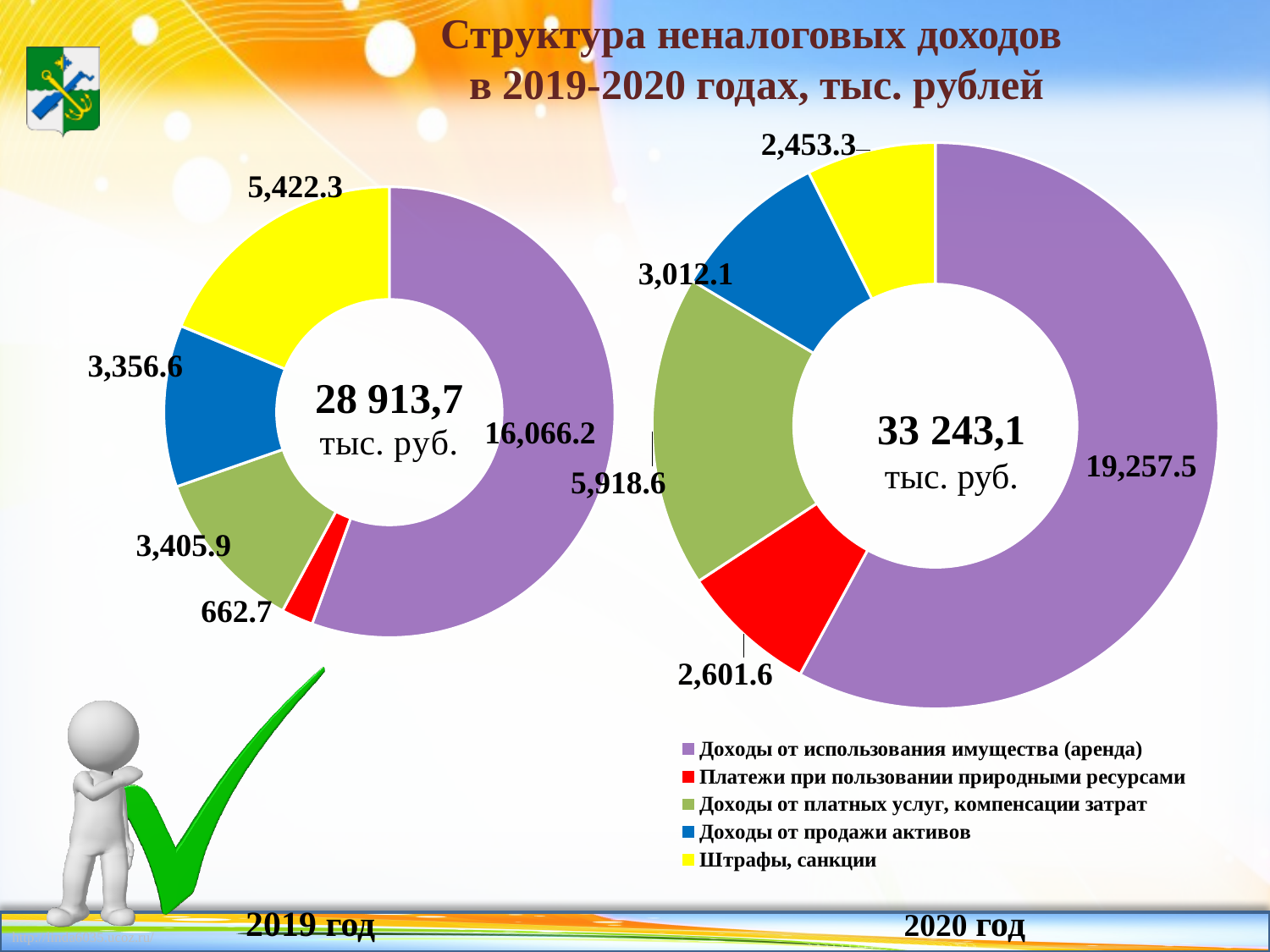
By how much did Доходы от использования имущества (аренда) increase from the 2019 chart to the 2020 chart? 3,191.3 In the 2019 chart, what is the difference between Штрафы, санкции and Доходы от продажи активов? 2,065.7 In the 2019 chart, which category has the smallest value? Платежи при пользовании природными ресурсами In the 2019 chart, what is the value for Доходы от использования имущества (аренда)? 16,066.2 In the 2019 chart, what is the value for Штрафы, санкции? 5,422.3 What kind of chart is used for the 2019 and 2020 data? doughnut chart How many categories does the legend list? 5 In the 2020 chart, which category has the smallest value? Штрафы, санкции In the 2020 chart, what is the value for Доходы от платных услуг, компенсации затрат? 5,918.6 In the 2020 chart, what is the value for Платежи при пользовании природными ресурсами? 2,601.6 In the 2020 chart, which category has the largest value? Доходы от использования имущества (аренда) In the 2020 chart, which is larger: Доходы от продажи активов or Штрафы, санкции? Доходы от продажи активов